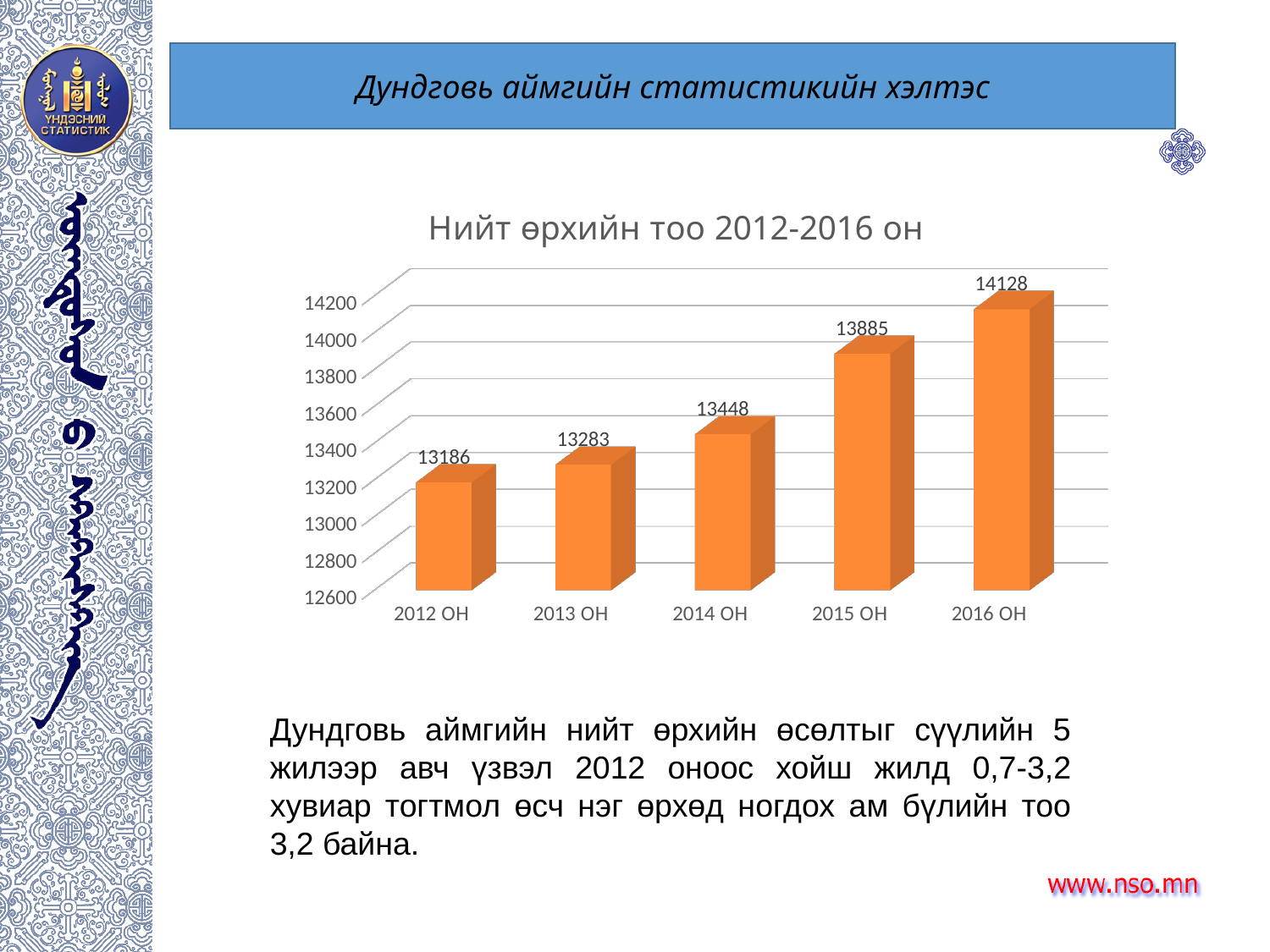
Which year has the highest value? 2016 ОН What kind of chart is shown on the slide? bar chart Do the values rise or fall from 2012 ОН to 2016 ОН? rise Which is larger, the value for 2013 ОН or the value for 2015 ОН? 2015 ОН Is the value for 2015 ОН greater or less than 13800? greater What is the difference between the values for 2016 ОН and 2012 ОН? 942 What is the value for 2012 ОН? 13186 How many years are shown on the chart? 5 Which year has the lowest value? 2012 ОН What is the value for 2014 ОН? 13448 What is the difference between the values for 2015 ОН and 2014 ОН? 437 What is the value for 2016 ОН? 14128